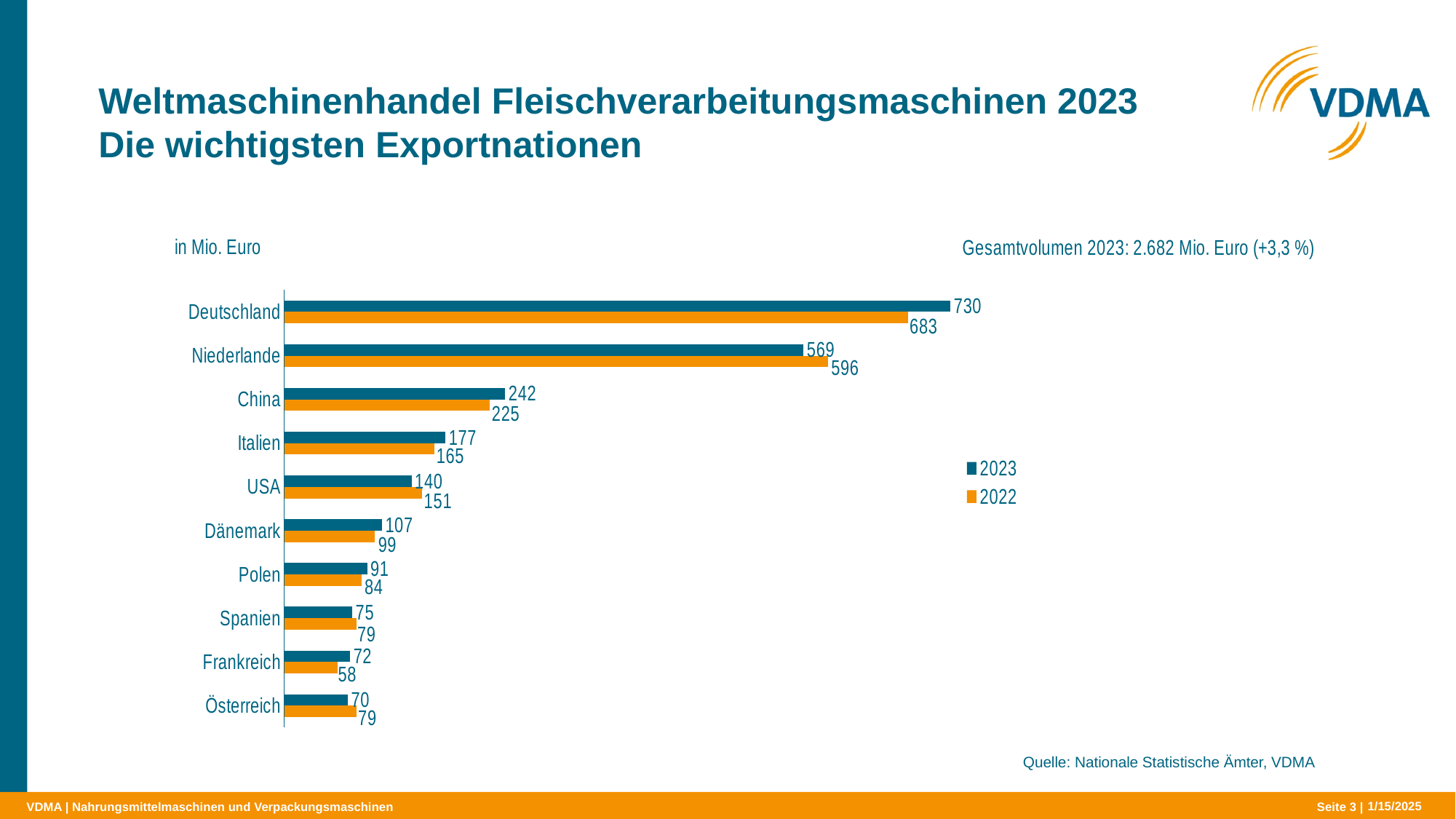
What is the 2023 value for USA? 140 How many series does the legend list? 2 What unit is stated for the values in the chart? in Mio. Euro Which country has the highest 2023 export value? Deutschland What is the difference between the 2023 and 2022 values for China? 17 Which country has the lowest 2023 export value? Österreich What kind of chart is shown on the slide? Bar chart What is the difference between the 2023 values for Deutschland and Niederlande? 161 What is the 2022 export value for Niederlande? 596 What is the 2023 export value for Deutschland? 730 How many countries are shown in the chart? 10 For USA, which year has the larger value, 2023 or 2022? 2022